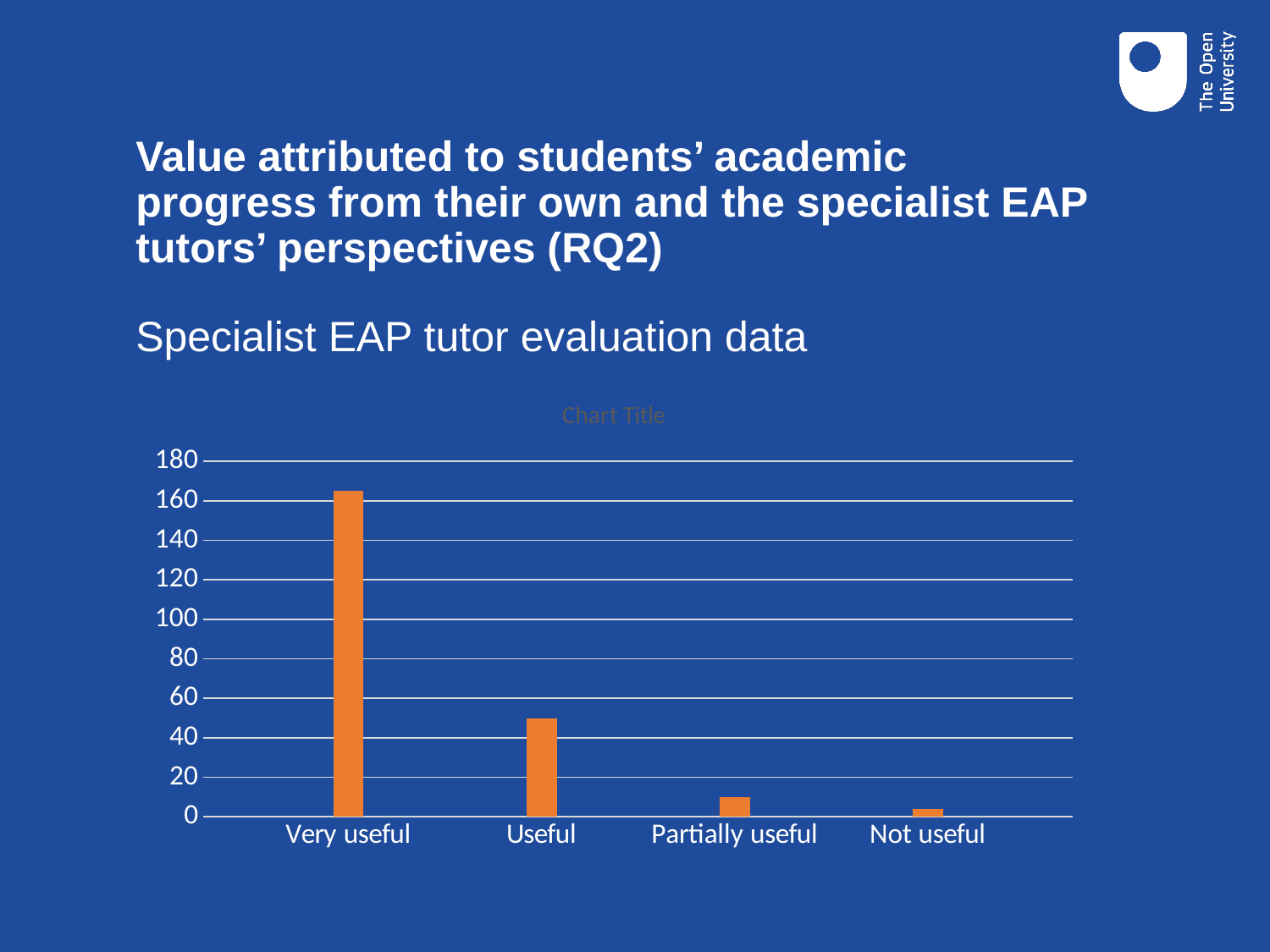
Is the value for Partially useful greater or less than 20? less Which category has the lowest value in the chart? Not useful What is the highest value shown on the chart's vertical axis? 180 Which category has the highest value in the chart? Very useful Is the value for Useful greater or less than 60? less Which is larger, the value for Useful or the value for Partially useful? Useful Is the value for Not useful greater or less than 20? less How many categories are shown on the x axis of the chart? 4 Do the values rise or fall moving from Very useful to Not useful along the x axis? fall What kind of chart is shown on the slide? bar chart